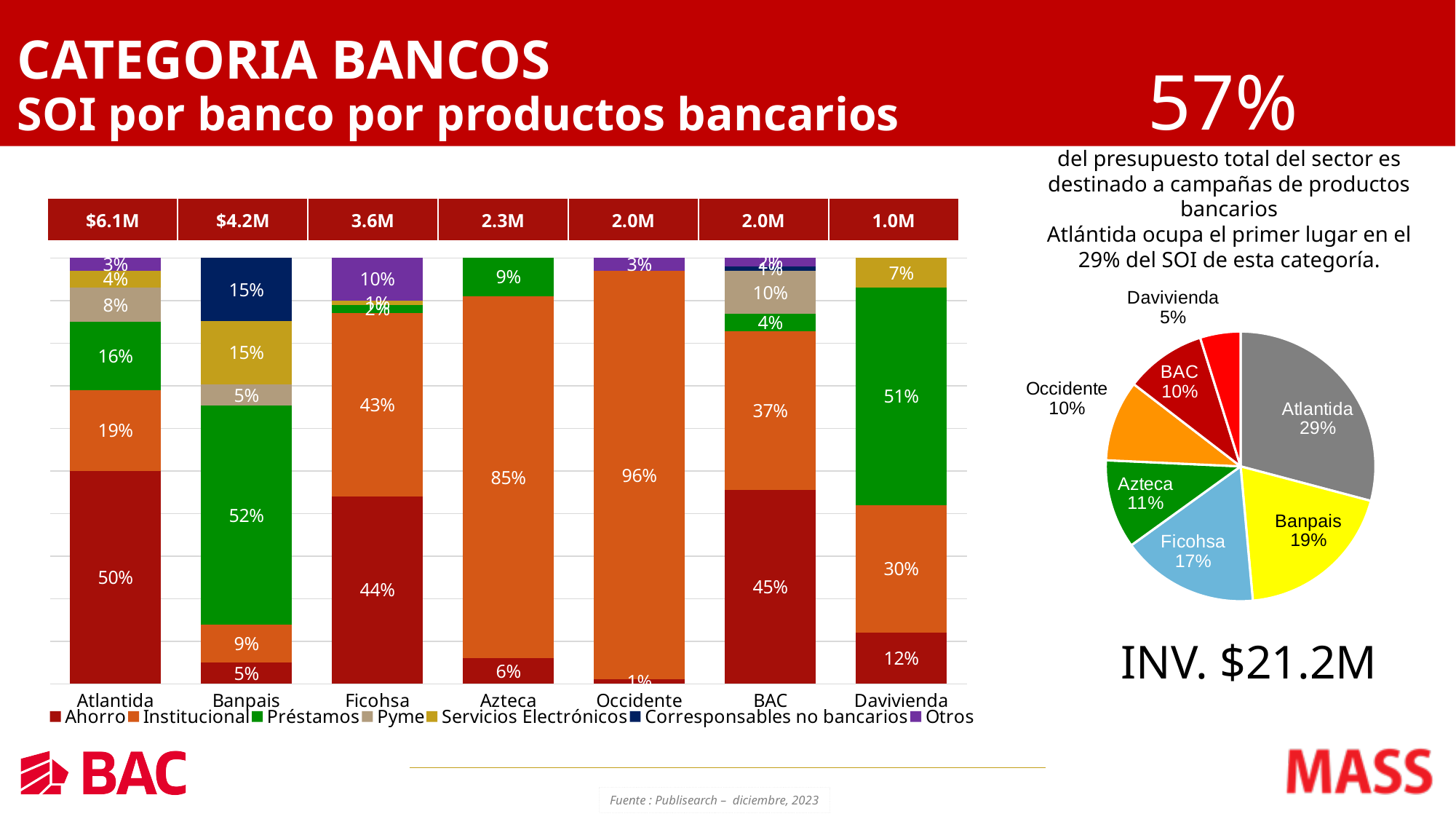
In the pie chart, which bank has the smallest slice? Davivienda In the stacked bar chart, which is larger: the Préstamos share for Davivienda or for Atlantida? Davivienda In the stacked bar chart, what is the difference between the Institucional share of Azteca and that of Ficohsa? 42% In the stacked bar chart, what is the Préstamos share for Banpais? 52% In the stacked bar chart, what is the Ahorro share for Davivienda? 12% In the stacked bar chart, what is the Institucional share for Occidente? 96% What type of chart is the chart on the left of the slide? Stacked bar chart How many banks are shown in the stacked bar chart? 7 How many series does the legend of the stacked bar chart list? 7 In the stacked bar chart, what total investment is shown above the Atlantida bar? $6.1M In the stacked bar chart, which bank has the highest Ahorro share? Atlantida In the pie chart, what share does Ficohsa have? 17%